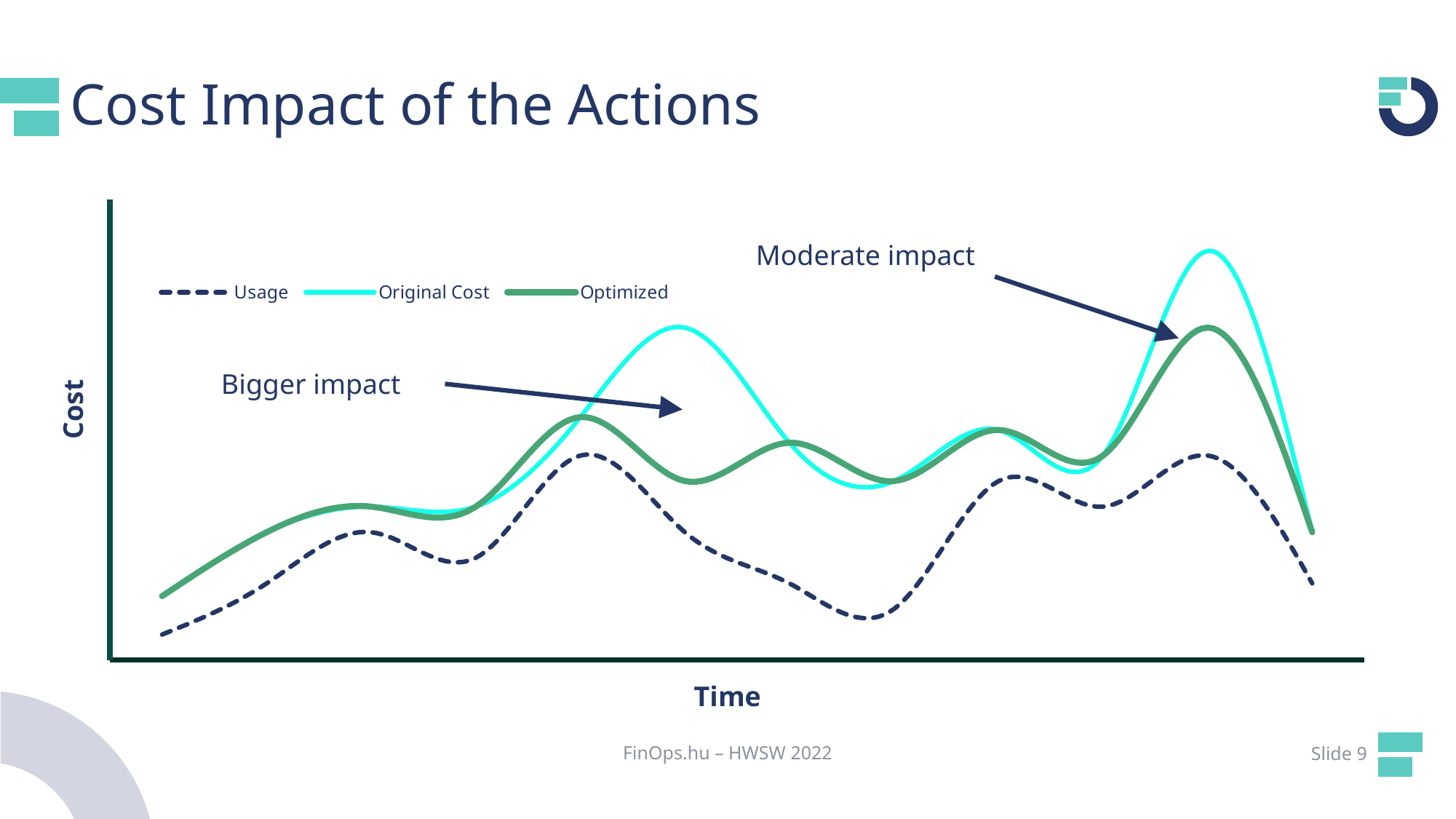
How many series does the legend list? 3 What is the label on the vertical axis? Cost Which series stays lowest across the whole chart? Usage What are the three series named in the legend? Usage, Original Cost, Optimized Which series is drawn as a dashed line? Usage At the peak in the middle of the chart (around the 'Bigger impact' arrow), which is higher: Original Cost or Optimized? Original Cost What kind of chart is shown on the slide? Line chart Which series reaches the highest point on the chart? Original Cost At the tallest peak near the right of the chart, which is higher: Original Cost or Optimized? Original Cost